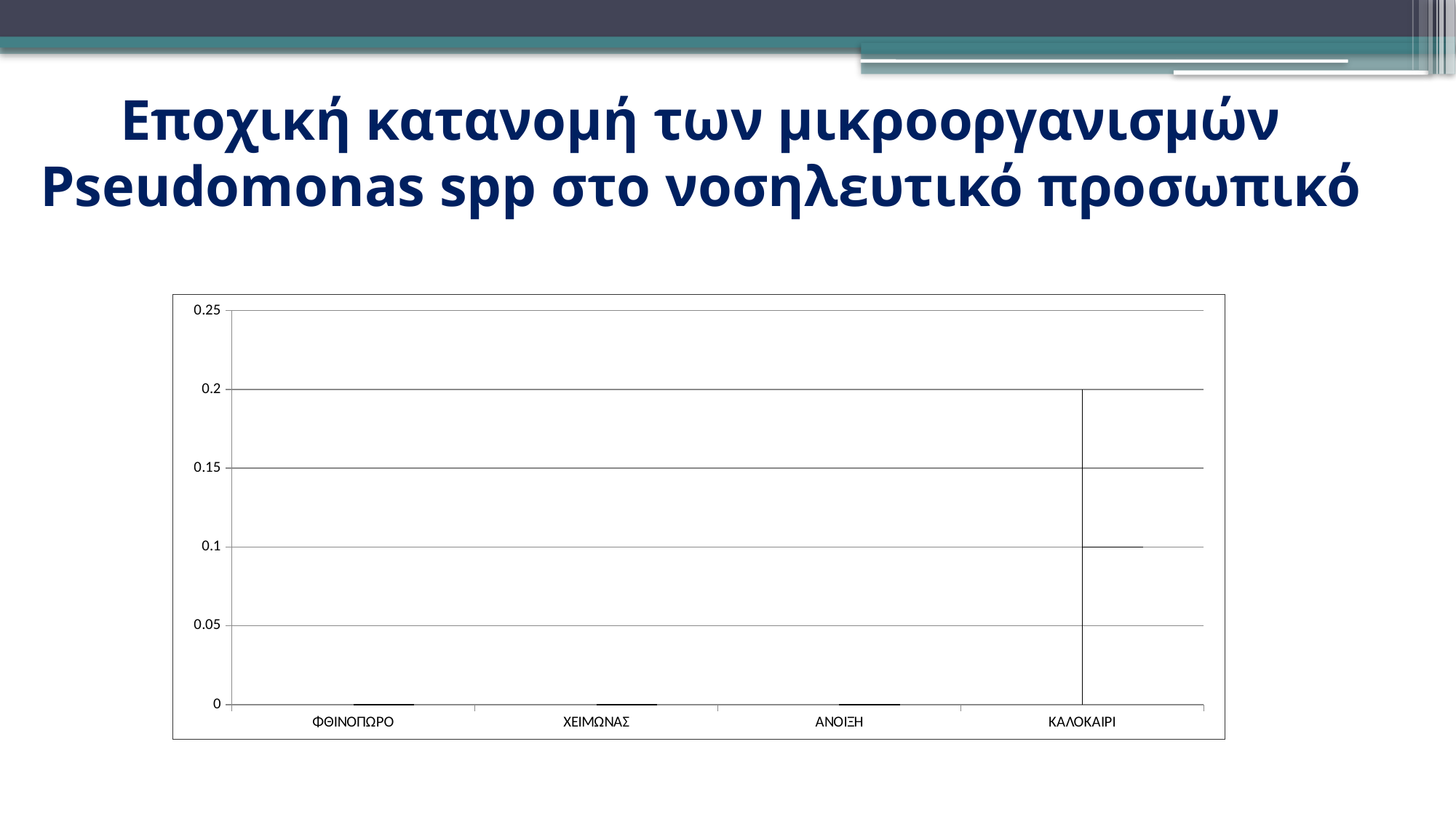
How many seasons (categories) are shown on the x axis of the chart? 4 What is the highest tick value shown on the vertical axis? 0.25 What is the value shown for ΦΘΙΝΟΠΩΡΟ? 0 Which has the larger value, ΚΑΛΟΚΑΙΡΙ or ΑΝΟΙΞΗ? ΚΑΛΟΚΑΙΡΙ What is the top value reached by the ΚΑΛΟΚΑΙΡΙ marker? 0.2 What is the value shown for ΧΕΙΜΩΝΑΣ? 0 Which season has the highest value in the chart? ΚΑΛΟΚΑΙΡΙ Which microorganism is named in the slide title? Pseudomonas spp Do the values rise or fall from ΑΝΟΙΞΗ to ΚΑΛΟΚΑΙΡΙ? rise Is the top value for ΚΑΛΟΚΑΙΡΙ greater or less than 0.15? greater How many seasons have a value of 0 in the chart? 3 What is the difference between the top value for ΚΑΛΟΚΑΙΡΙ and the value for ΑΝΟΙΞΗ? 0.2